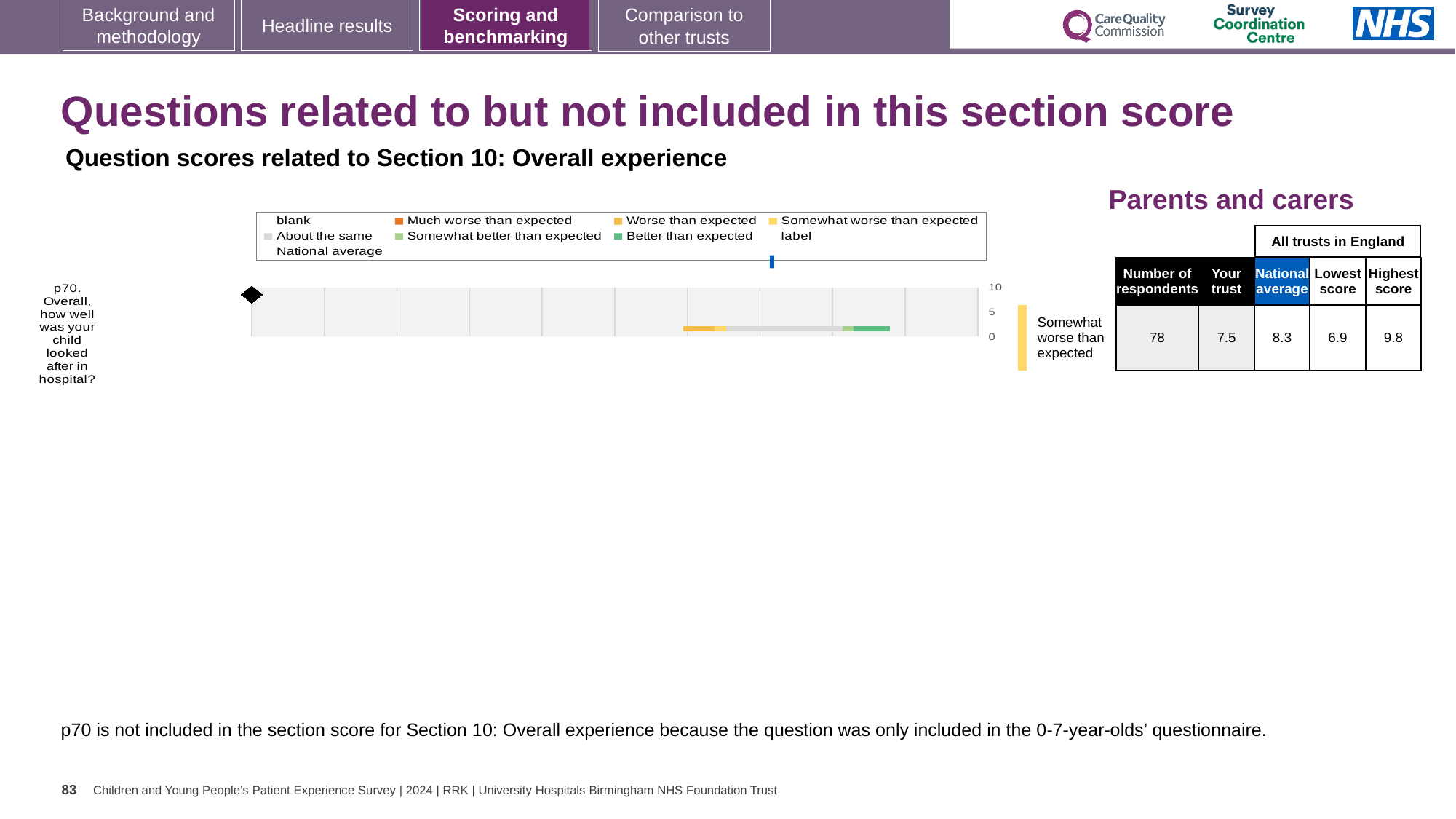
In the table next to the chart, what is the lowest score among all trusts in England for p70? 6.9 Which benchmark category is the trust's result for p70 labelled as? Somewhat worse than expected Which is larger for p70: the 'Your trust' score or the national average? National average What colour does the legend use for 'Better than expected'? green What is the highest value shown on the chart's axis? 10 In the table next to the chart, what is the highest score among all trusts in England for p70? 9.8 In the table next to the chart, what is the 'Your trust' score for p70? 7.5 In the table next to the chart, what is the national average score for p70? 8.3 What kind of chart is used to show the p70 question score? bar chart How many questions are plotted in the chart? 1 What is the difference between the national average (8.3) and the 'Your trust' score (7.5) for p70? 0.8 How many respondents answered p70 according to the table next to the chart? 78